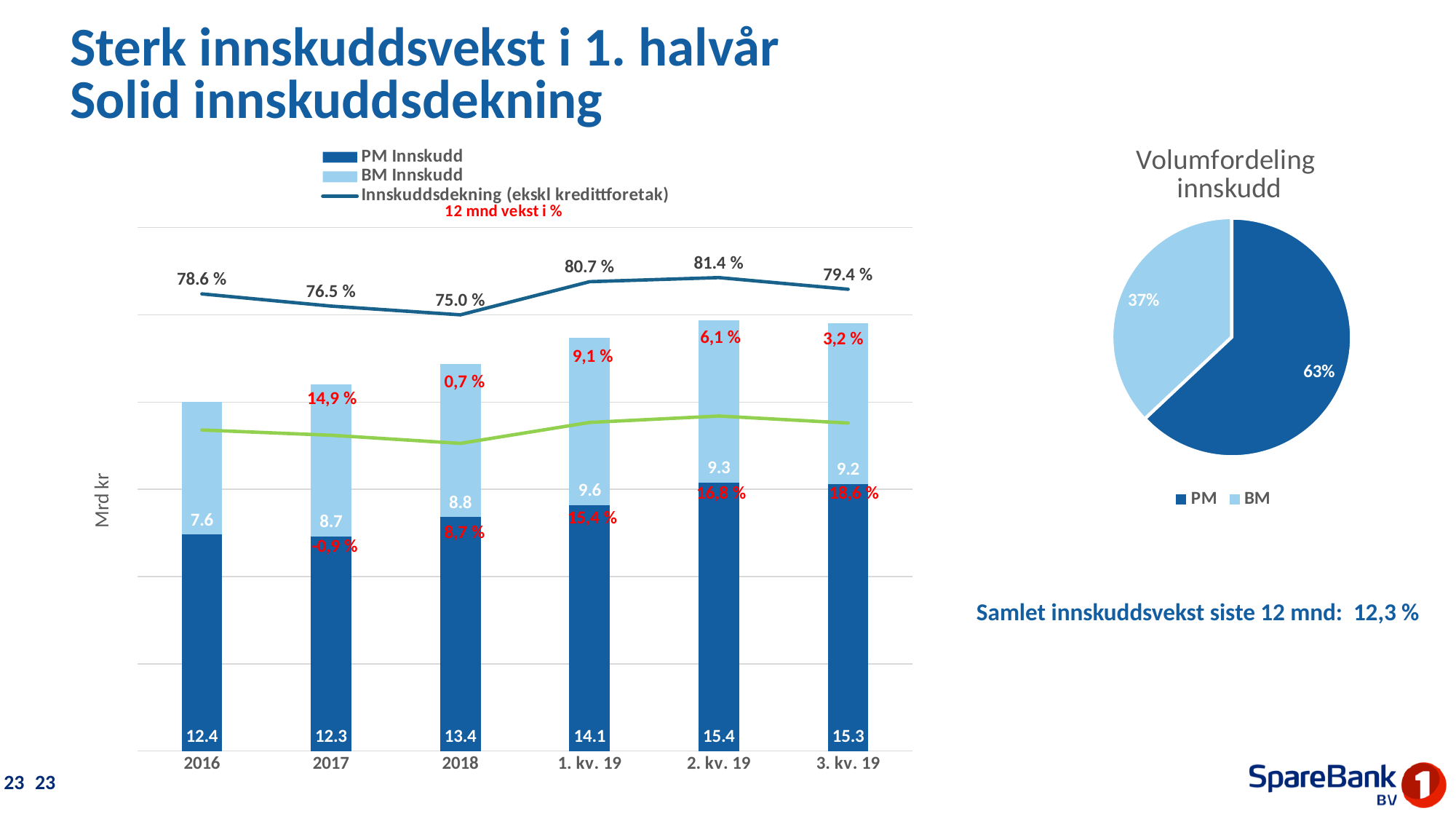
What kind of chart is the chart titled Volumfordeling innskudd? Pie chart How many categories are shown on the x axis of the left bar chart? 6 In the left bar chart, what is the BM Innskudd value for 2016? 7.6 In the left bar chart, which is larger: the BM Innskudd value for 1. kv. 19 or for 3. kv. 19? 1. kv. 19 In the left chart, what is the Innskuddsdekning (ekskl kredittforetak) value for 2018? 75.0 % In the left bar chart, what is the difference between the PM Innskudd values for 2. kv. 19 and 2016? 3.0 How many series does the legend of the left chart list? 3 In the left bar chart, which category has the lowest PM Innskudd value? 2017 In the left bar chart, what is the PM Innskudd value for 2. kv. 19? 15.4 In the left chart, which category has the highest Innskuddsdekning (ekskl kredittforetak) value? 2. kv. 19 In the pie chart titled Volumfordeling innskudd, what share does PM have? 63% In the left bar chart, what is the total of the stacked bar for 2018 (PM Innskudd plus BM Innskudd)? 22.2